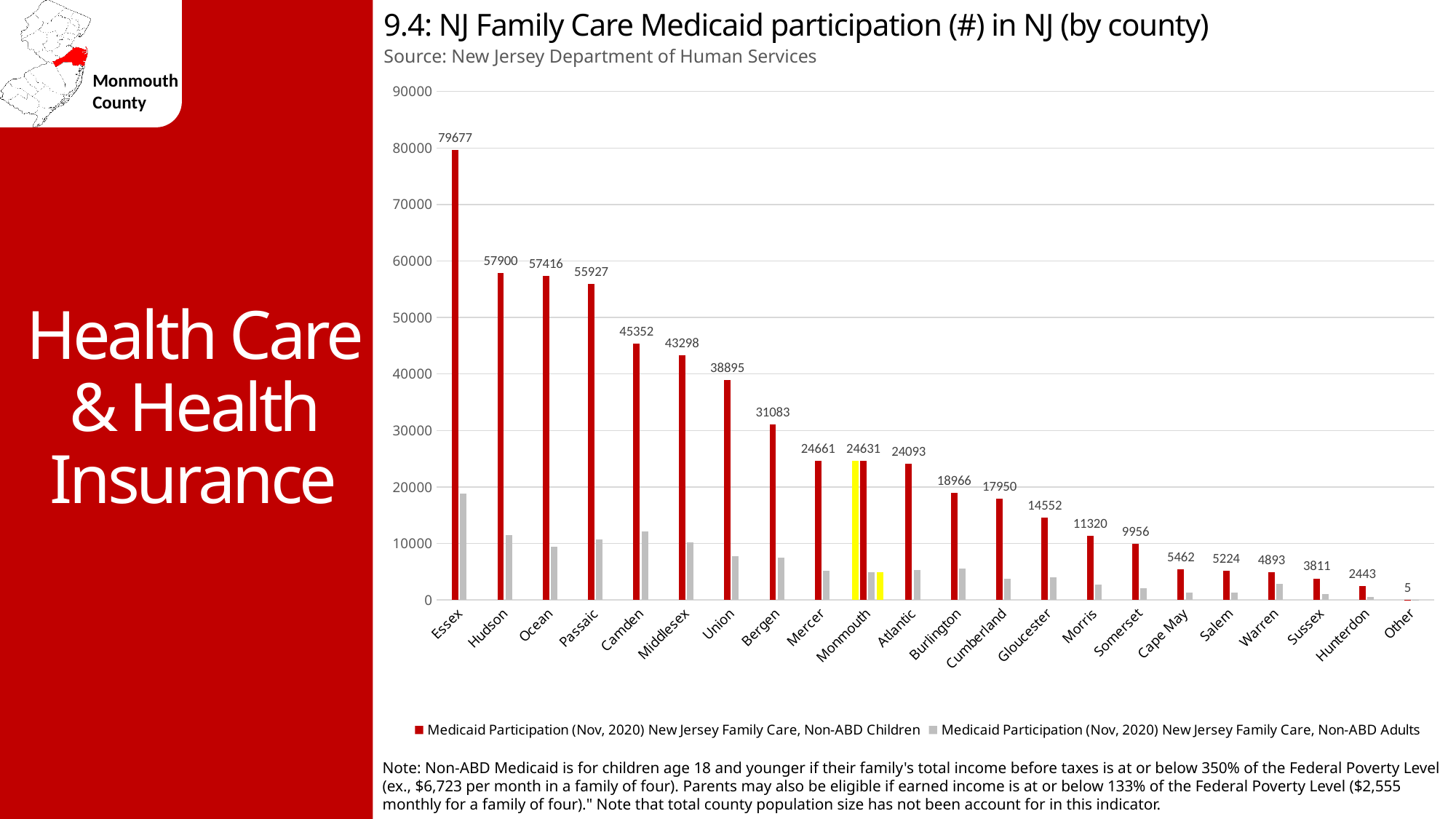
Which category has the lowest Non-ABD Children Medicaid participation? Other What is the Non-ABD Children Medicaid participation value for Essex? 79677 How many counties/categories are shown along the x axis? 22 Do the Non-ABD Children values rise or fall moving from left to right along the x axis? fall Which county has the highest Non-ABD Children Medicaid participation? Essex What type of chart is shown on the slide? bar chart What is the difference between the Non-ABD Children values for Hudson and Ocean? 484 What is the Non-ABD Children Medicaid participation value for Monmouth? 24631 Which has a larger Non-ABD Children value, Camden or Union? Camden How many series does the legend list? 2 Is the Non-ABD Adults value for Essex greater or less than 10000? greater Which county's bars are highlighted in yellow on the chart? Monmouth